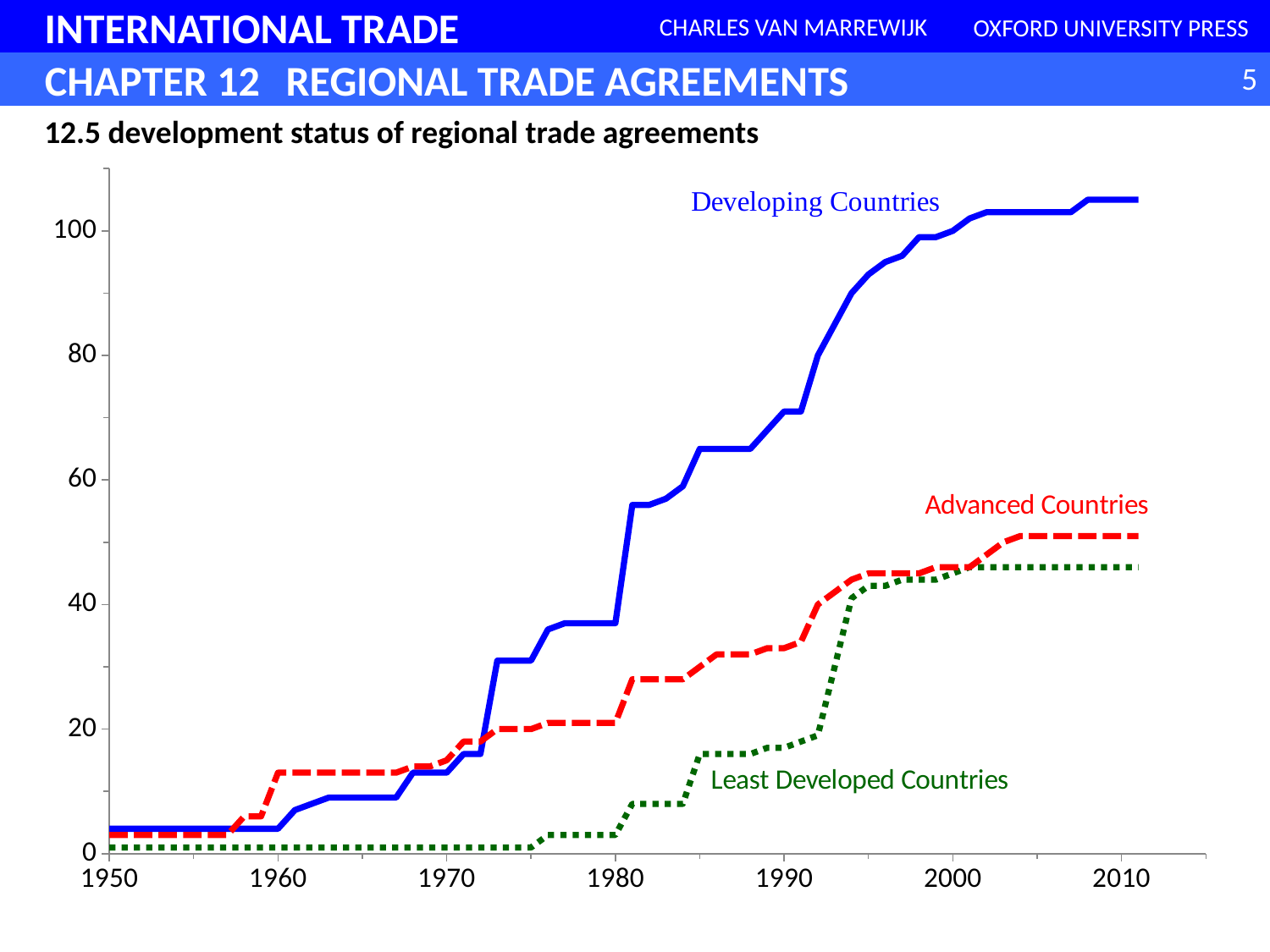
What colour is the line for Developing Countries? blue Is the value for Least Developed Countries in 1980 greater or less than 20? less How many series are plotted on the chart? 3 Which series has the highest value in 2010? Developing Countries Is the value for Advanced Countries in 2010 greater or less than 60? less Is the value for Developing Countries in 1990 greater or less than 60? greater What kind of chart is shown on the slide? line chart In 1990, which is larger: the value for Advanced Countries or for Least Developed Countries? Advanced Countries Does the value for Developing Countries rise or fall from 1950 to 2010? rise Which series has the lowest value in 2010? Least Developed Countries